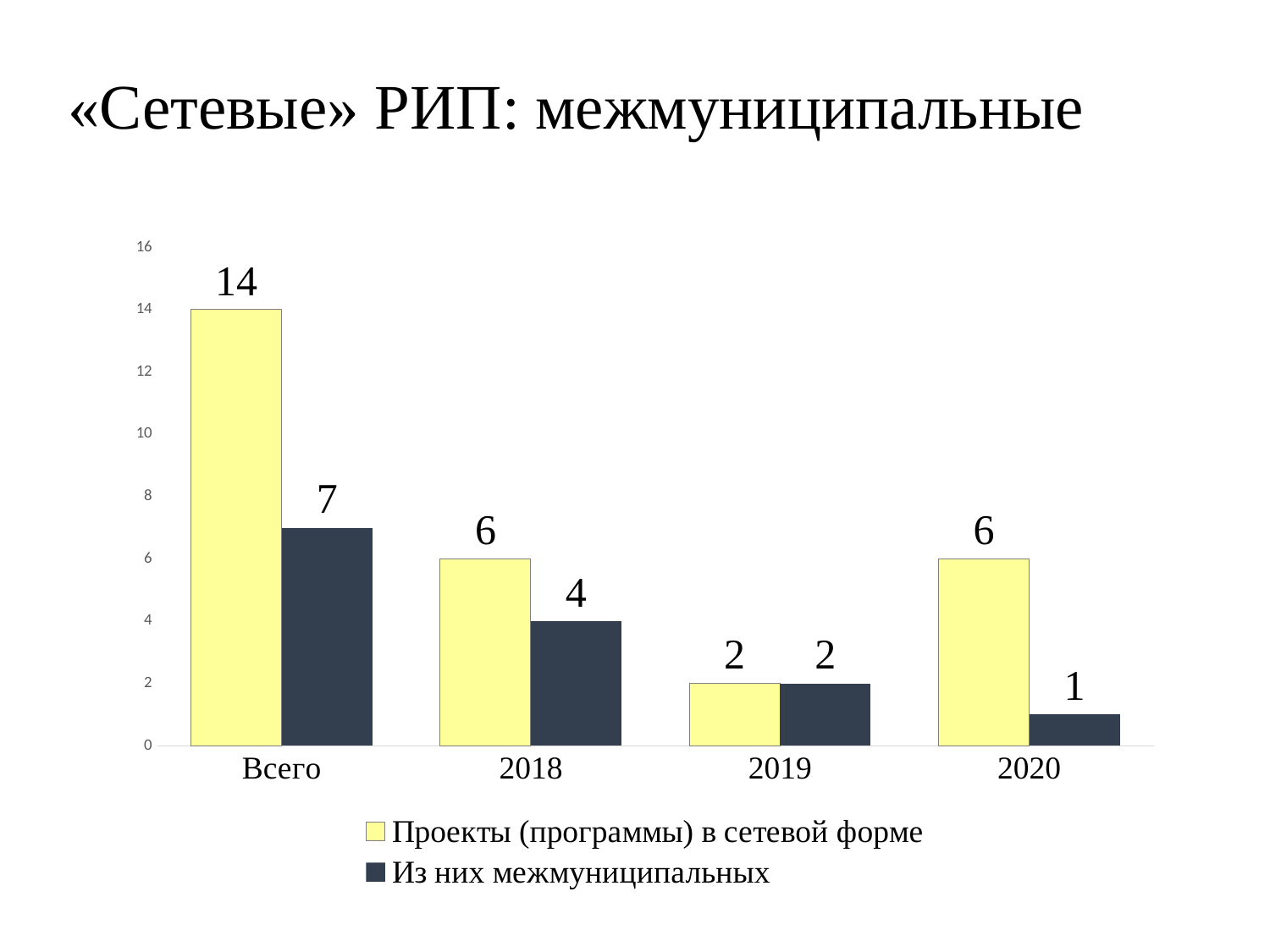
What is the difference between «Проекты (программы) в сетевой форме» and «Из них межмуниципальных» for «Всего»? 7 How many series does the legend list? 2 What is the title of the slide? «Сетевые» РИП: межмуниципальные How many categories are shown on the x axis? 4 What kind of chart is shown on the slide? bar chart Is the value of «Проекты (программы) в сетевой форме» for «Всего» greater or less than 10? greater What is the value of «Из них межмуниципальных» for 2020? 1 Which is larger: «Проекты (программы) в сетевой форме» for 2018 or for 2019? 2018 Which category has the lowest value for «Из них межмуниципальных»? 2020 Which category has the highest value for «Проекты (программы) в сетевой форме»? Всего What is the value of «Проекты (программы) в сетевой форме» for «Всего»? 14 What is the value of «Из них межмуниципальных» for 2018? 4